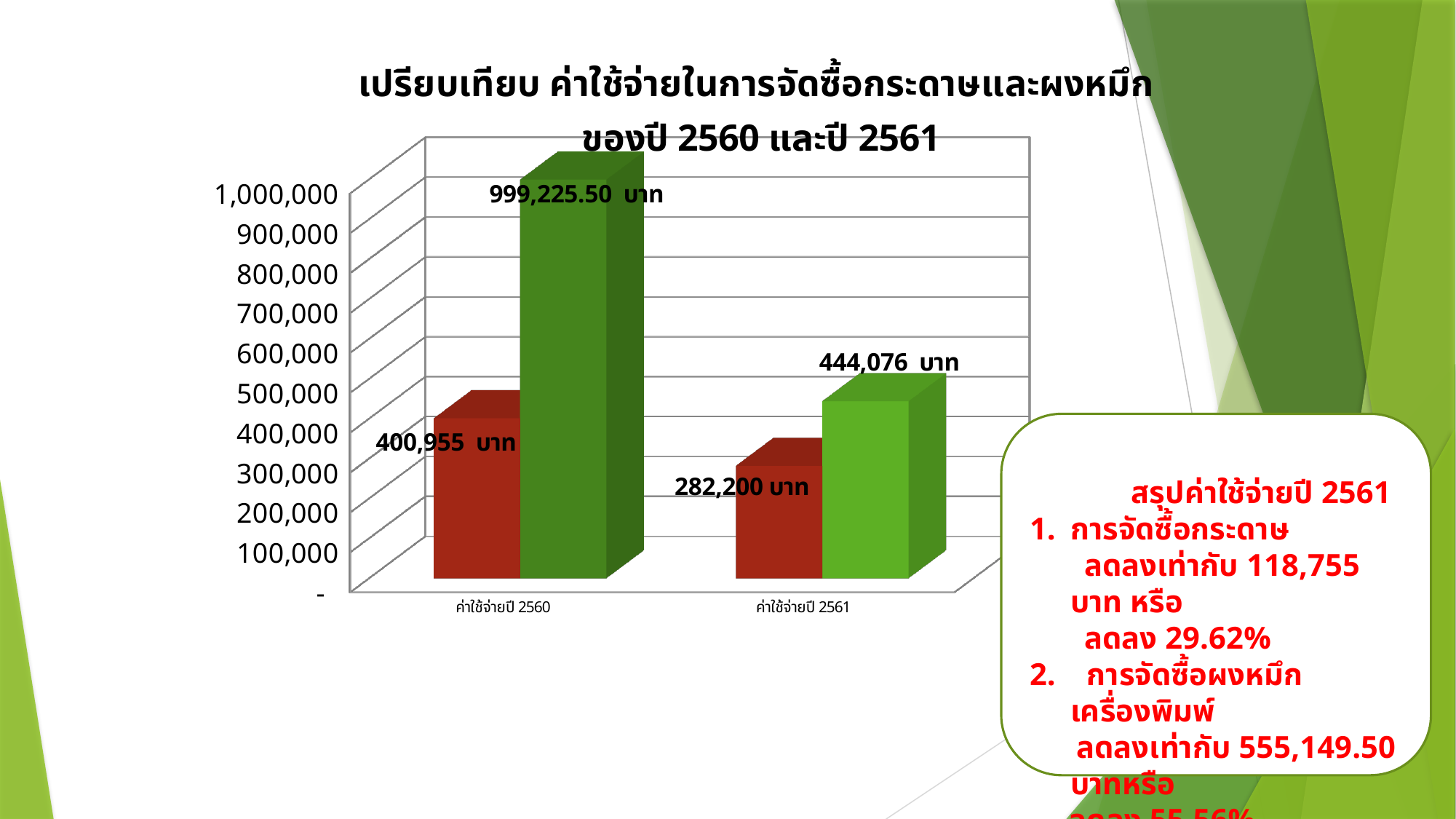
How many categories are shown on the x axis of the chart? 2 What is the value of the green bar for ค่าใช้จ่ายปี 2560? 999,225.50 บาท Which is larger: the green bar for ค่าใช้จ่ายปี 2561 or the red bar for ค่าใช้จ่ายปี 2560? The green bar for ค่าใช้จ่ายปี 2561 Which bar has the lowest value in the chart? The red bar for ค่าใช้จ่ายปี 2561 (282,200 บาท) What is the difference between the red bar values for ค่าใช้จ่ายปี 2560 and ค่าใช้จ่ายปี 2561? 118,755 บาท Do the green bar values rise or fall from ค่าใช้จ่ายปี 2560 to ค่าใช้จ่ายปี 2561? Fall What is the value of the green bar for ค่าใช้จ่ายปี 2561? 444,076 บาท What is the difference between the green bar values for ค่าใช้จ่ายปี 2560 and ค่าใช้จ่ายปี 2561? 555,149.50 บาท What type of chart is shown on the slide? Bar chart Which bar has the highest value in the chart? The green bar for ค่าใช้จ่ายปี 2560 (999,225.50 บาท) What is the value of the red bar for ค่าใช้จ่ายปี 2561? 282,200 บาท What is the value of the red bar for ค่าใช้จ่ายปี 2560? 400,955 บาท